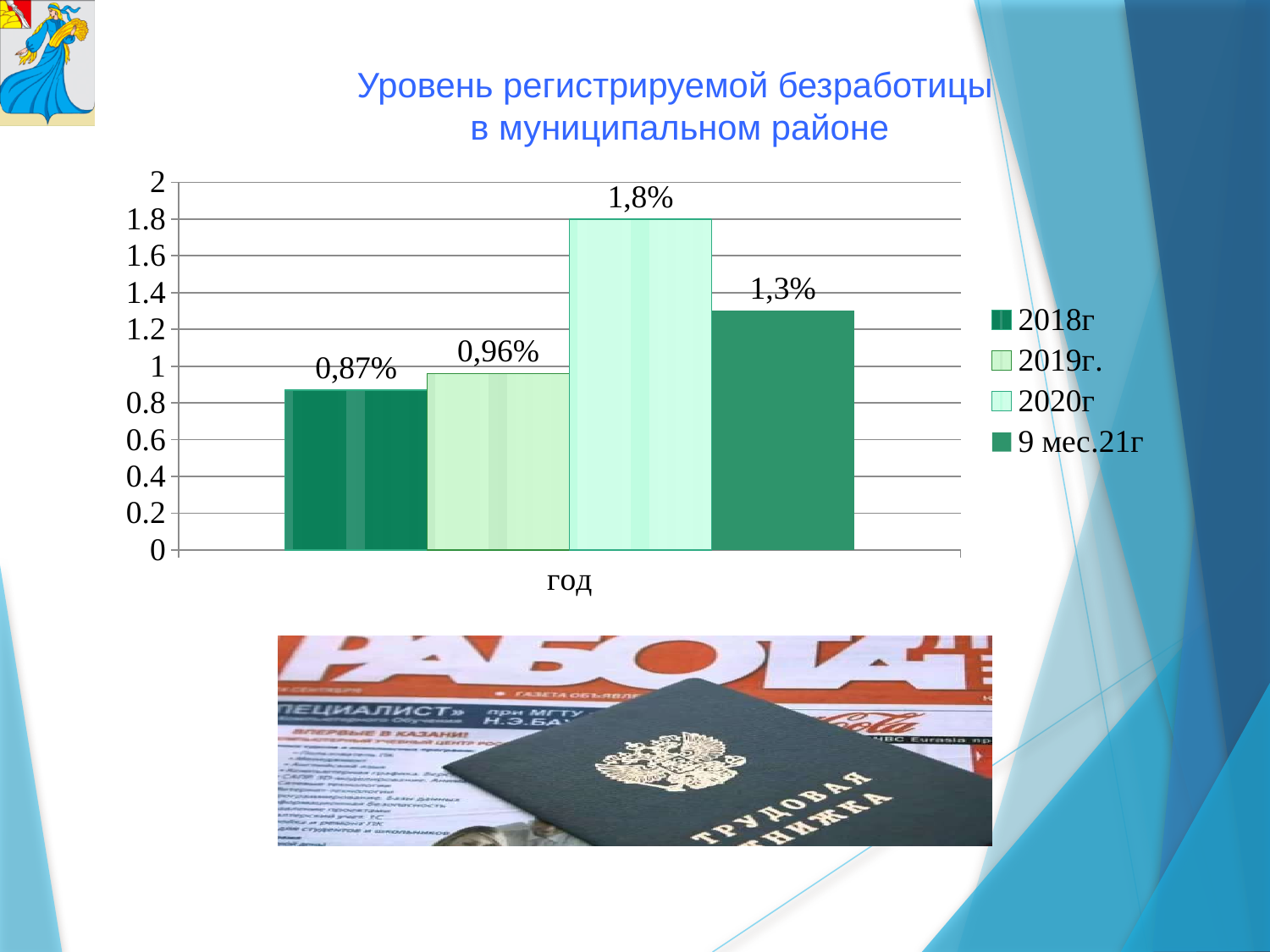
How many series does the legend list? 4 What kind of chart is shown on the slide? Bar chart What is the registered unemployment rate shown for 9 мес.21г? 1,3% What is the registered unemployment rate shown for 2018г? 0,87% By how much does the 2020г rate exceed the 9 мес.21г rate? 0,5% What is the registered unemployment rate shown for 2020г? 1,8% Is the value for 2020г greater or less than 1.6? greater Which period has the lowest registered unemployment rate? 2018г What is the label on the horizontal axis of the chart? год Which period has the highest registered unemployment rate? 2020г Which is larger, the rate for 2019г. or the rate for 9 мес.21г? 9 мес.21г What is the registered unemployment rate shown for 2019г.? 0,96%